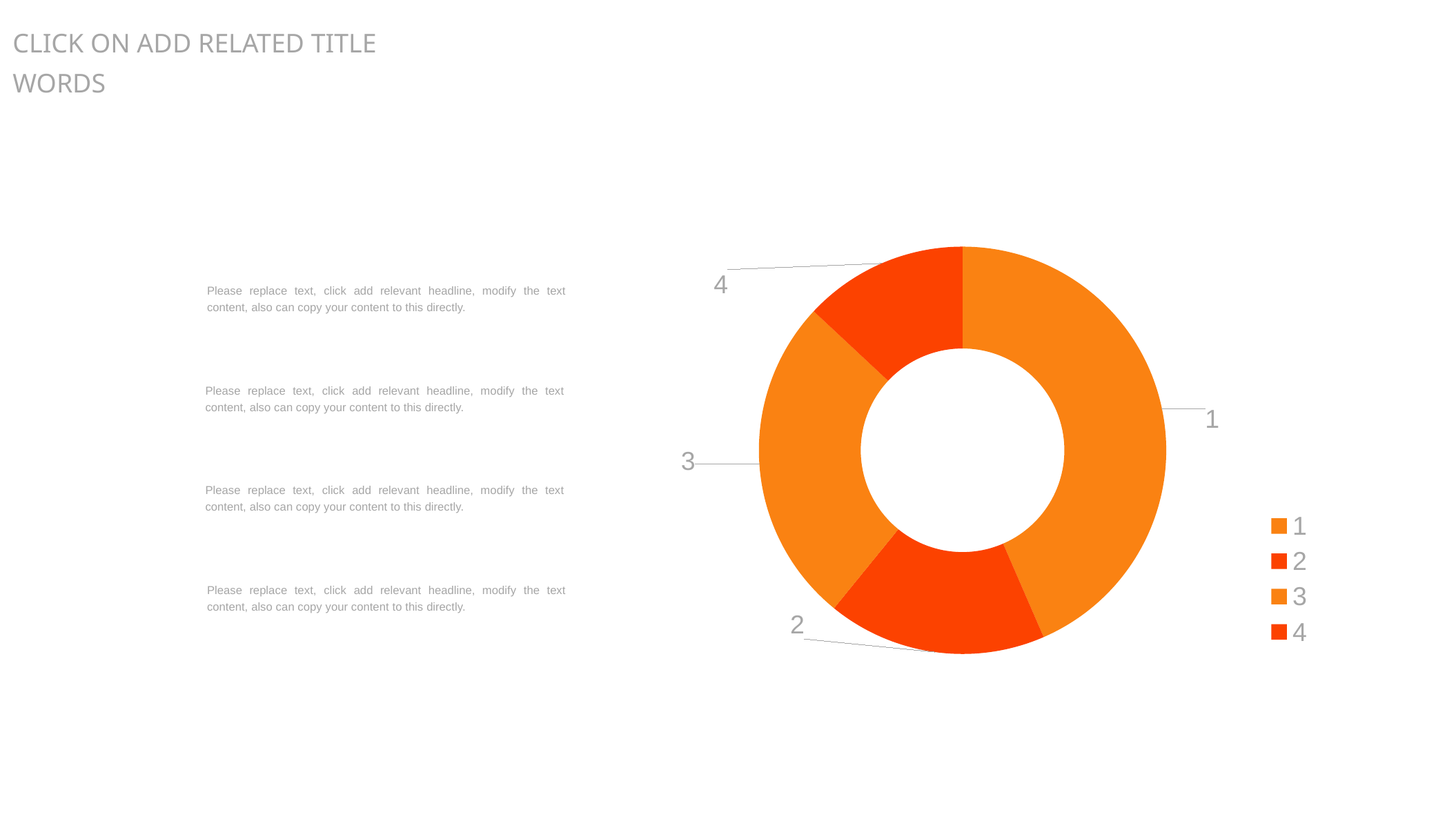
Which slice is larger, category 2 or category 4? 2 Which slice is larger, category 1 or category 4? 1 Which category's slice is located on the right side of the doughnut chart? 1 What kind of chart is shown on the slide? doughnut chart Which category has the largest slice in the doughnut chart? 1 Which slice is larger, category 1 or category 3? 1 Which category has the smallest slice in the doughnut chart? 4 How many entries does the legend list? 4 How many slices does the doughnut chart have? 4 What are the legend entries of the chart, in order? 1, 2, 3, 4